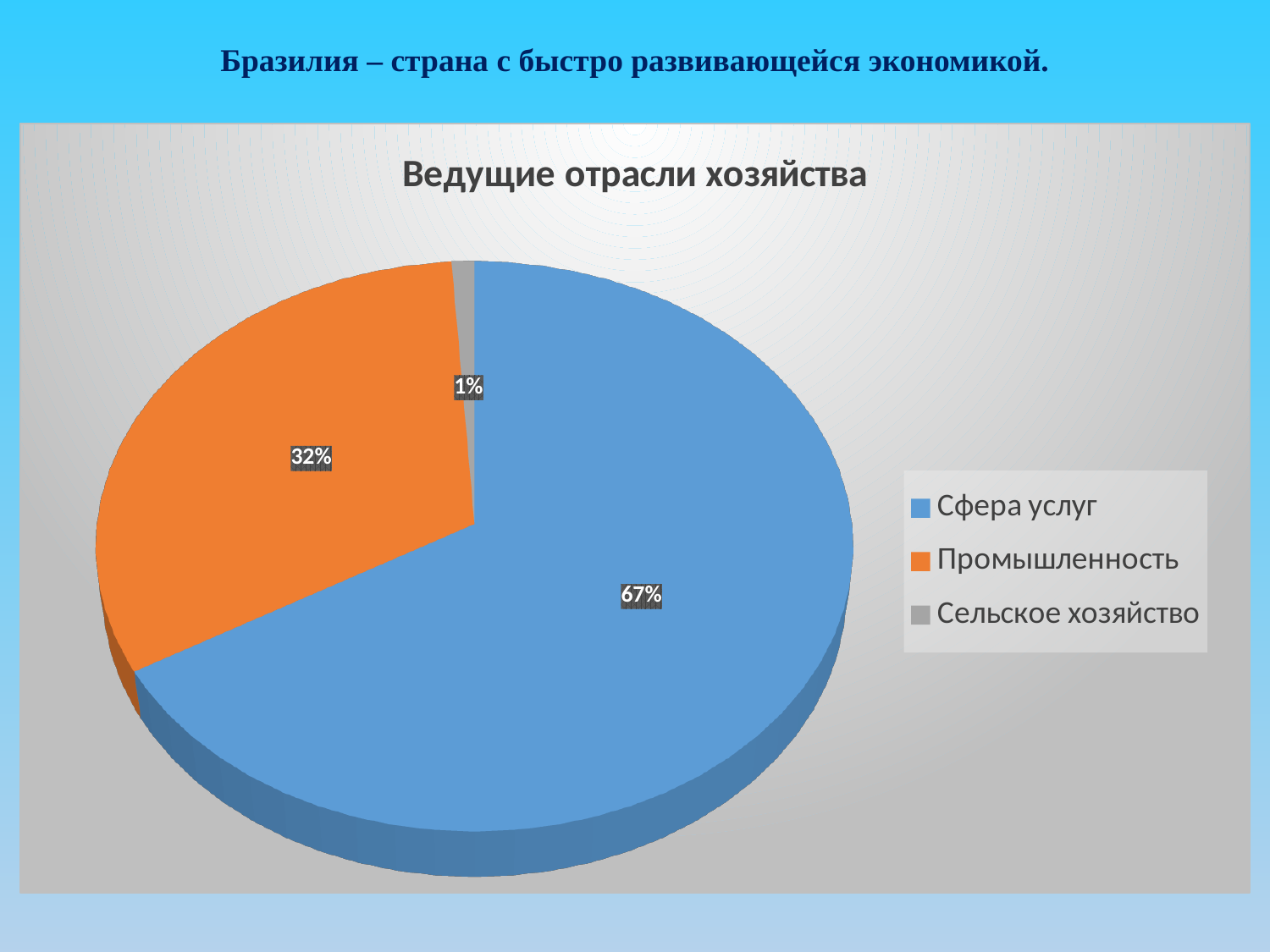
What share of the pie does Промышленность have? 32% What is the title of the chart? Ведущие отрасли хозяйства What kind of chart is shown on the slide? Pie chart Which category has the largest share of the pie? Сфера услуг Which category has the smallest share of the pie? Сельское хозяйство What colour is the slice for Промышленность? Orange What is the difference between the shares of Сфера услуг and Промышленность? 35% What share of the pie does Сфера услуг have? 67% What is the difference between the shares of Промышленность and Сельское хозяйство? 31% Which is larger, the share of Промышленность or the share of Сельское хозяйство? Промышленность What share of the pie does Сельское хозяйство have? 1% How many categories does the pie chart show? 3